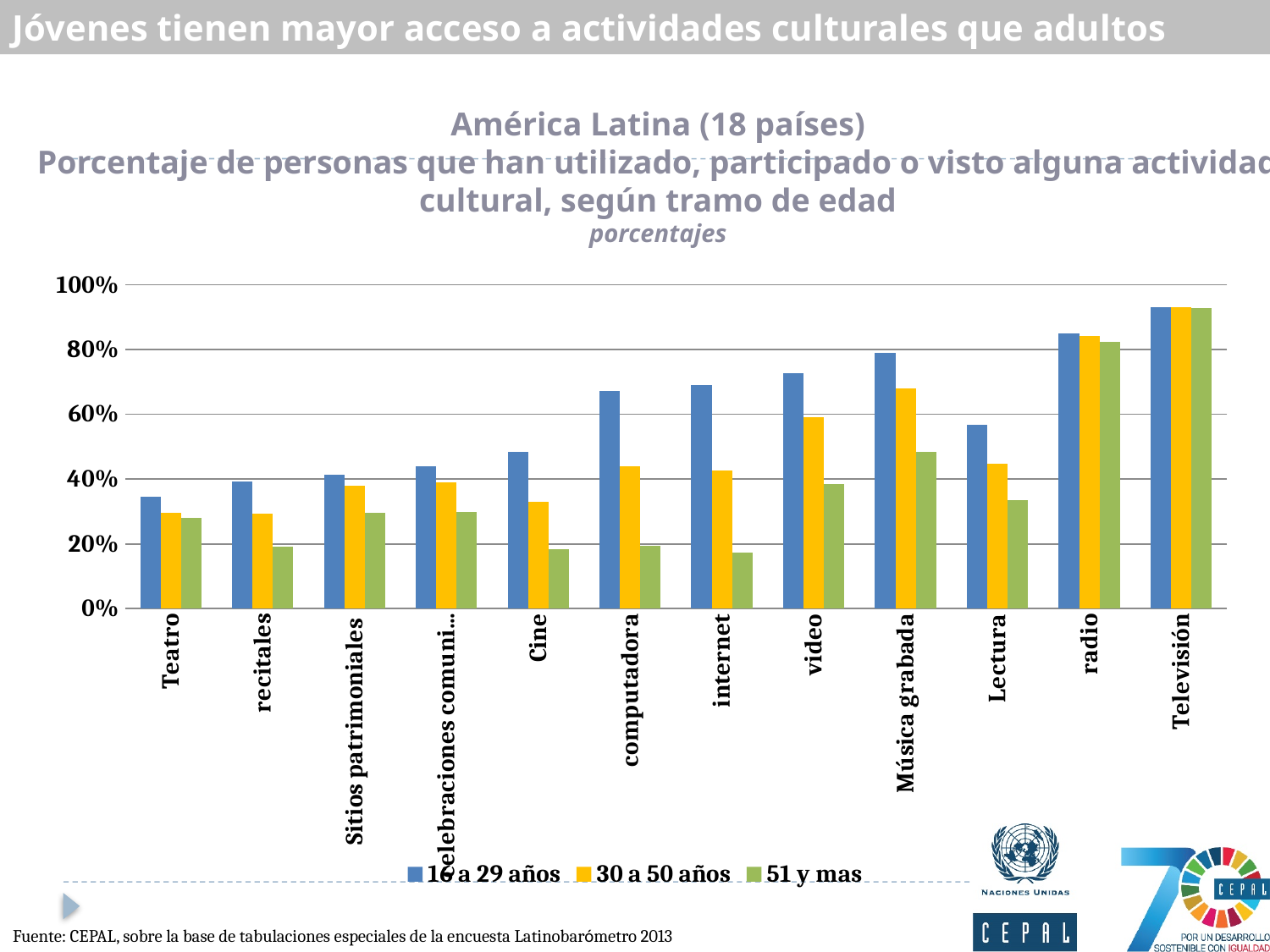
Is the value for internet in the 51 y mas series greater or less than 20%? less For internet, which series has the larger value: 16 a 29 años or 51 y mas? 16 a 29 años What kind of chart is shown on the slide? bar chart Which category has the highest value for the 16 a 29 años series? Televisión Which category has the highest value for the 51 y mas series? Televisión In the 30 a 50 años series, which is larger: video or Lectura? video How many series does the legend list? 3 Which colour represents the 51 y mas series in the legend? green Is the value for video in the 16 a 29 años series greater or less than 60%? greater Which category has the lowest value for the 16 a 29 años series? Teatro How many cultural activity categories are shown on the x axis? 12 Is the value for Música grabada in the 30 a 50 años series greater or less than 60%? greater